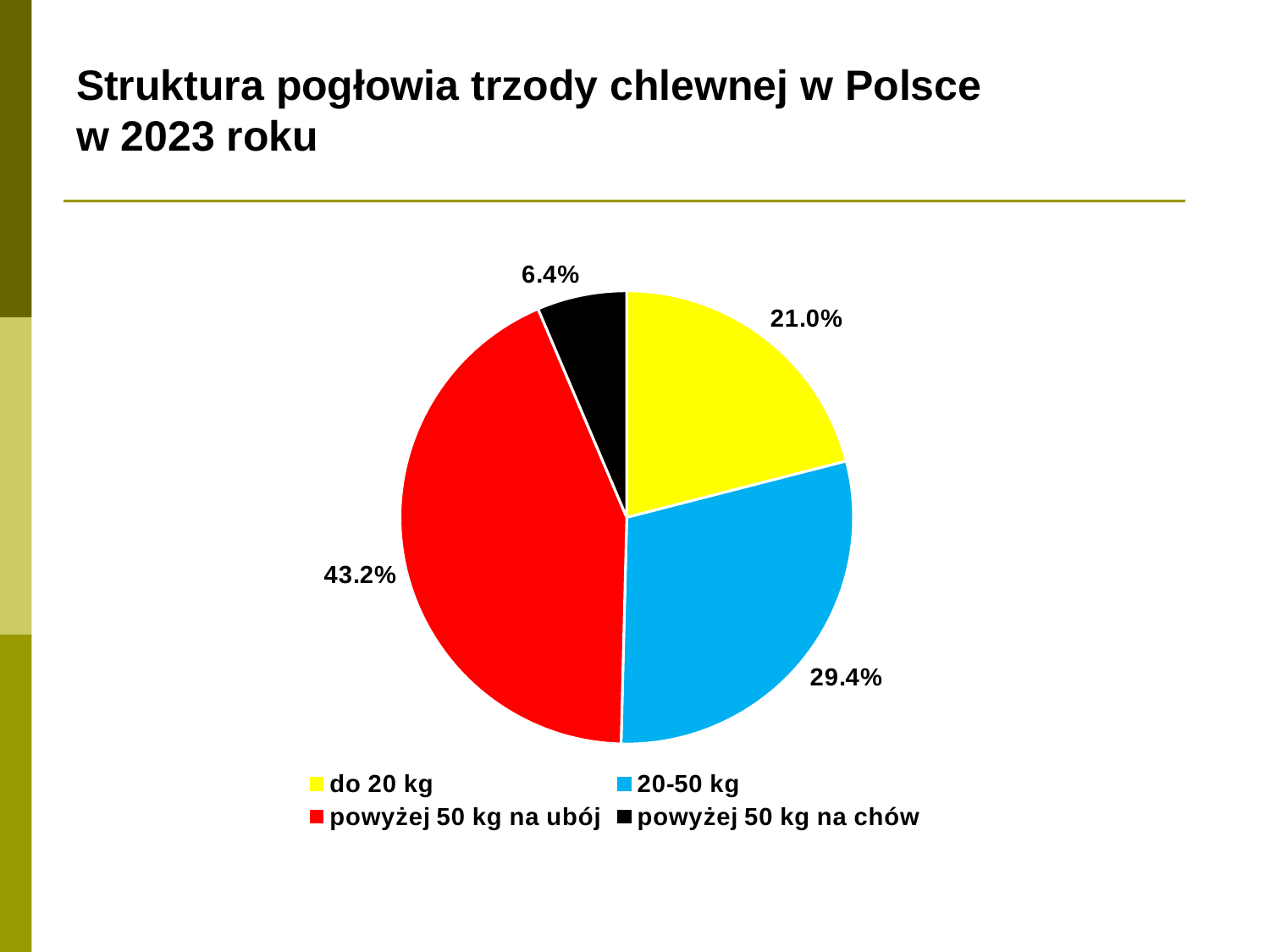
What share of the pie does the 'powyżej 50 kg na ubój' slice represent? 43.2% Which is larger: the '20-50 kg' slice or the 'do 20 kg' slice? 20-50 kg How many categories does the pie chart show? 4 What is the title of the slide containing the chart? Struktura pogłowia trzody chlewnej w Polsce w 2023 roku What share of the pie does the '20-50 kg' slice represent? 29.4% What is the difference in percentage points between the 'powyżej 50 kg na ubój' slice and the '20-50 kg' slice? 13.8 What colour is the slice for 'powyżej 50 kg na ubój'? red What kind of chart is shown on the slide? pie chart Which category has the smallest slice of the pie? powyżej 50 kg na chów What share of the pie does the 'powyżej 50 kg na chów' slice represent? 6.4% Which category has the largest slice of the pie? powyżej 50 kg na ubój